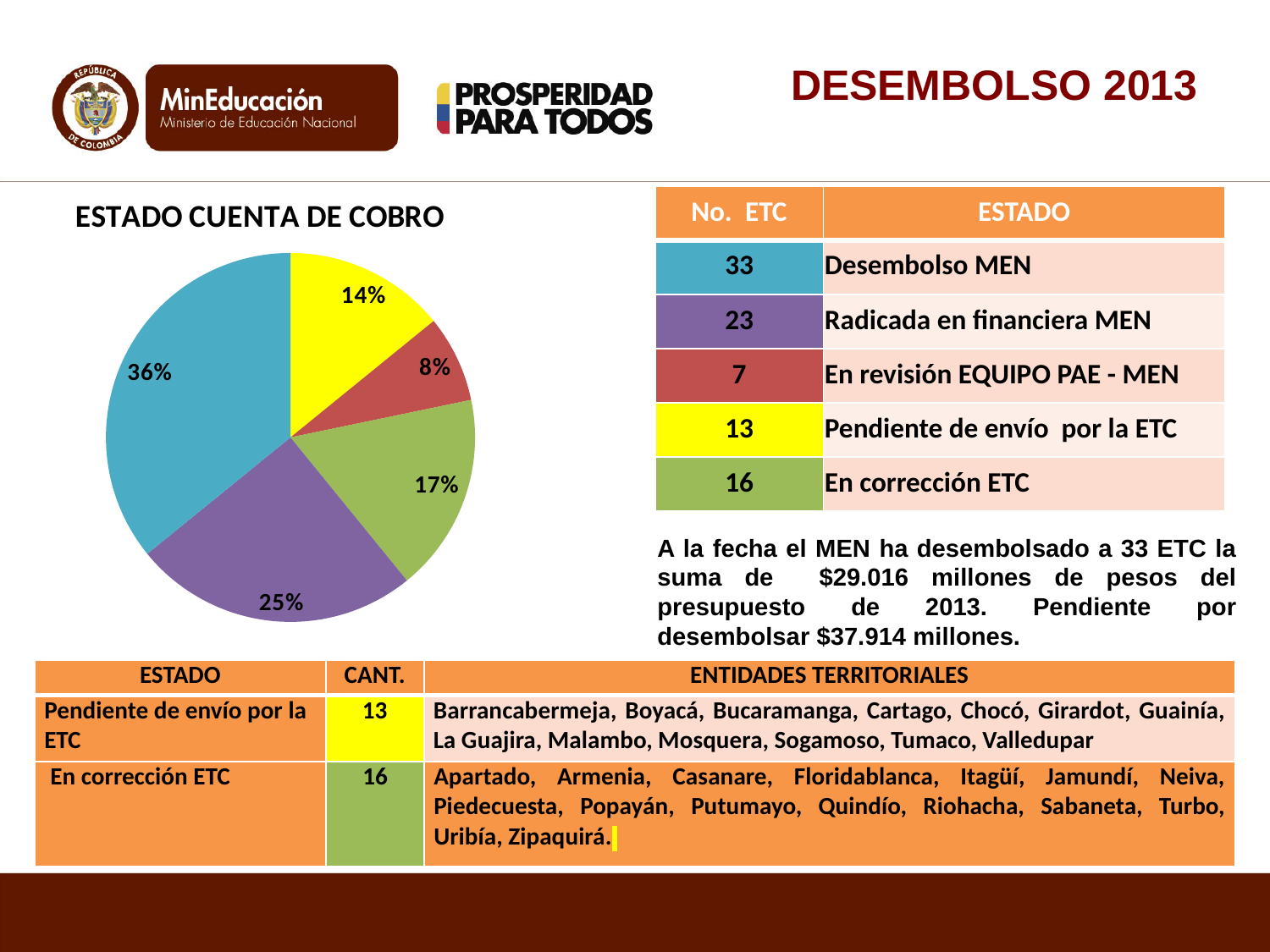
What percentage is shown on the largest slice of the "ESTADO CUENTA DE COBRO" pie chart? 36% In the "ESTADO CUENTA DE COBRO" pie chart, what is the difference in percentage points between the blue slice (36%) and the purple slice (25%)? 11 How many slices does the "ESTADO CUENTA DE COBRO" pie chart have? 5 According to the colour key table next to the pie chart, which estado does the blue slice (36%) represent? Desembolso MEN In the "ESTADO CUENTA DE COBRO" pie chart, what percentage is shown on the green slice? 17% What kind of chart is shown under the title "ESTADO CUENTA DE COBRO"? pie chart In the "ESTADO CUENTA DE COBRO" pie chart, what is the combined percentage of the yellow (14%) and green (17%) slices? 31% In the "ESTADO CUENTA DE COBRO" pie chart, what percentage is shown on the yellow slice? 14% What percentage is shown on the smallest slice of the "ESTADO CUENTA DE COBRO" pie chart? 8% In the "ESTADO CUENTA DE COBRO" pie chart, which slice is larger, the green one or the red one? the green one According to the colour key table next to the pie chart, which estado does the red slice (8%) represent? En revisión EQUIPO PAE - MEN In the "ESTADO CUENTA DE COBRO" pie chart, what percentage is shown on the purple slice? 25%